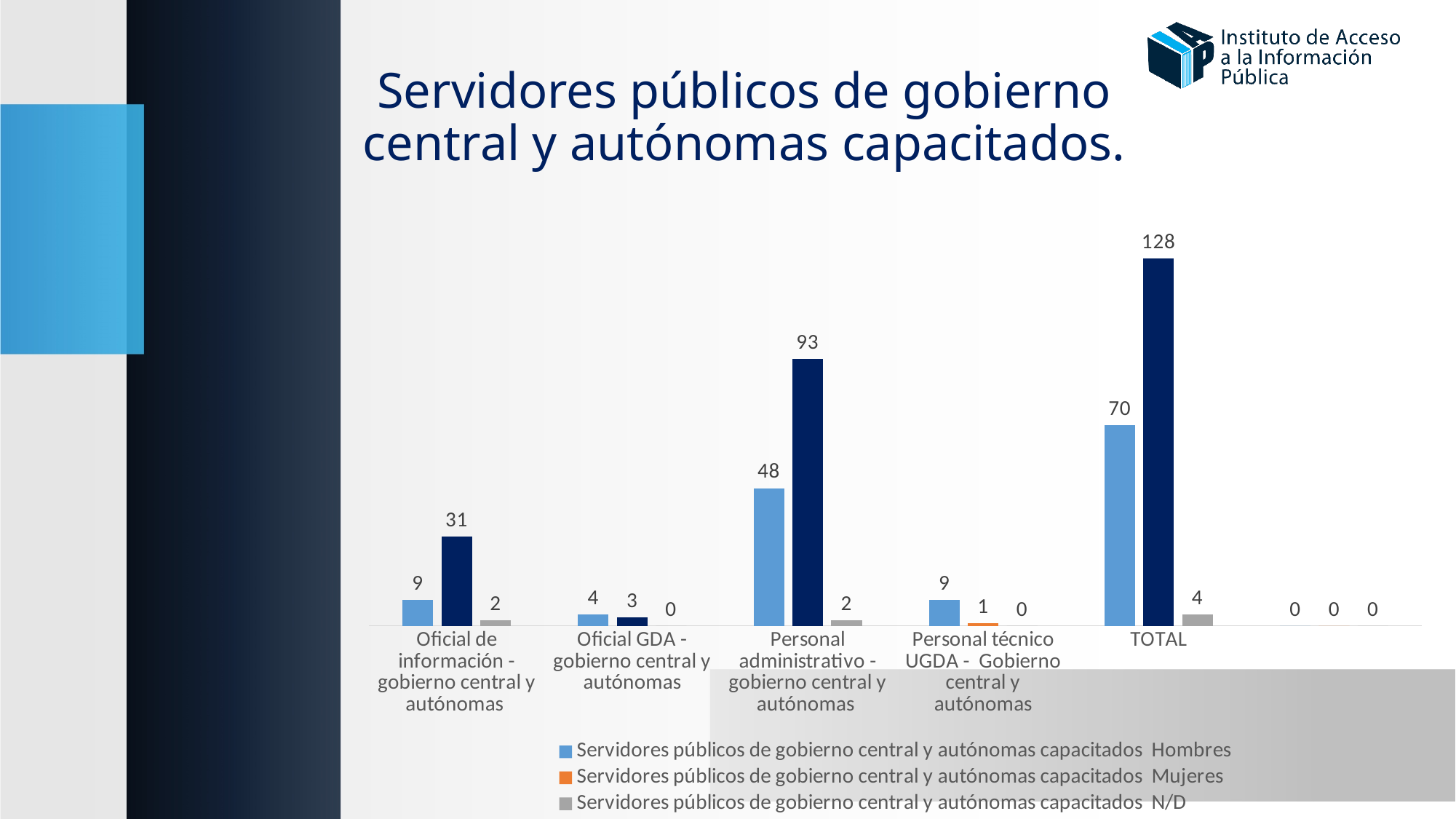
What is the title of the slide? Servidores públicos de gobierno central y autónomas capacitados. What kind of chart is shown on the slide? Bar chart What is the Hombres value for Oficial GDA - gobierno central y autónomas? 4 How many series does the legend list? 3 What is the Mujeres value for Personal técnico UGDA - Gobierno central y autónomas? 1 What is the Hombres value for TOTAL? 70 What is the value of the tallest bar in the chart? 128 What is the difference between the Hombres values for Personal administrativo and Oficial de información? 39 Which is larger, the Hombres value for Oficial de información or the Hombres value for Oficial GDA? Oficial de información What is the N/D value for TOTAL? 4 Which category has the lowest Hombres value? Oficial GDA - gobierno central y autónomas What is the Hombres value for Personal administrativo - gobierno central y autónomas? 48